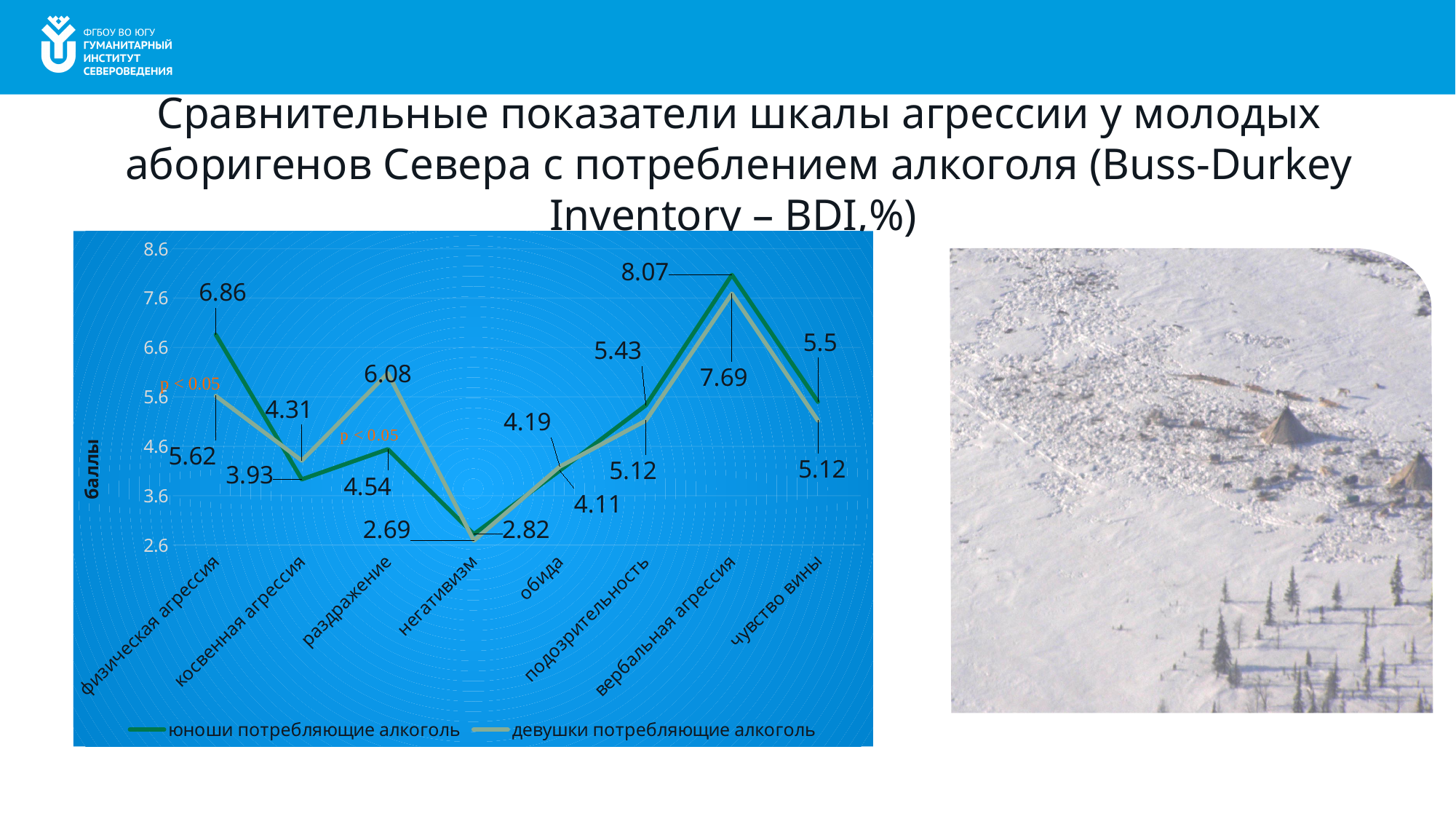
At раздражение, which series has the larger value, юноши or девушки потребляющие алкоголь? девушки потребляющие алкоголь Which category has the highest value for девушки потребляющие алкоголь? вербальная агрессия What is the value for юноши потребляющие алкоголь at вербальная агрессия? 8.07 What is the label on the vertical axis? баллы What is the difference between юноши and девушки at вербальная агрессия? 0.38 What is the value for юноши потребляющие алкоголь at физическая агрессия? 6.86 How many categories are plotted along the x axis? 8 How many series does the legend list? 2 Which category has the lowest value for юноши потребляющие алкоголь? негативизм What is the value for девушки потребляющие алкоголь at раздражение? 6.08 What type of chart is shown on the slide? line chart Do the values for юноши потребляющие алкоголь rise or fall from вербальная агрессия to чувство вины? fall